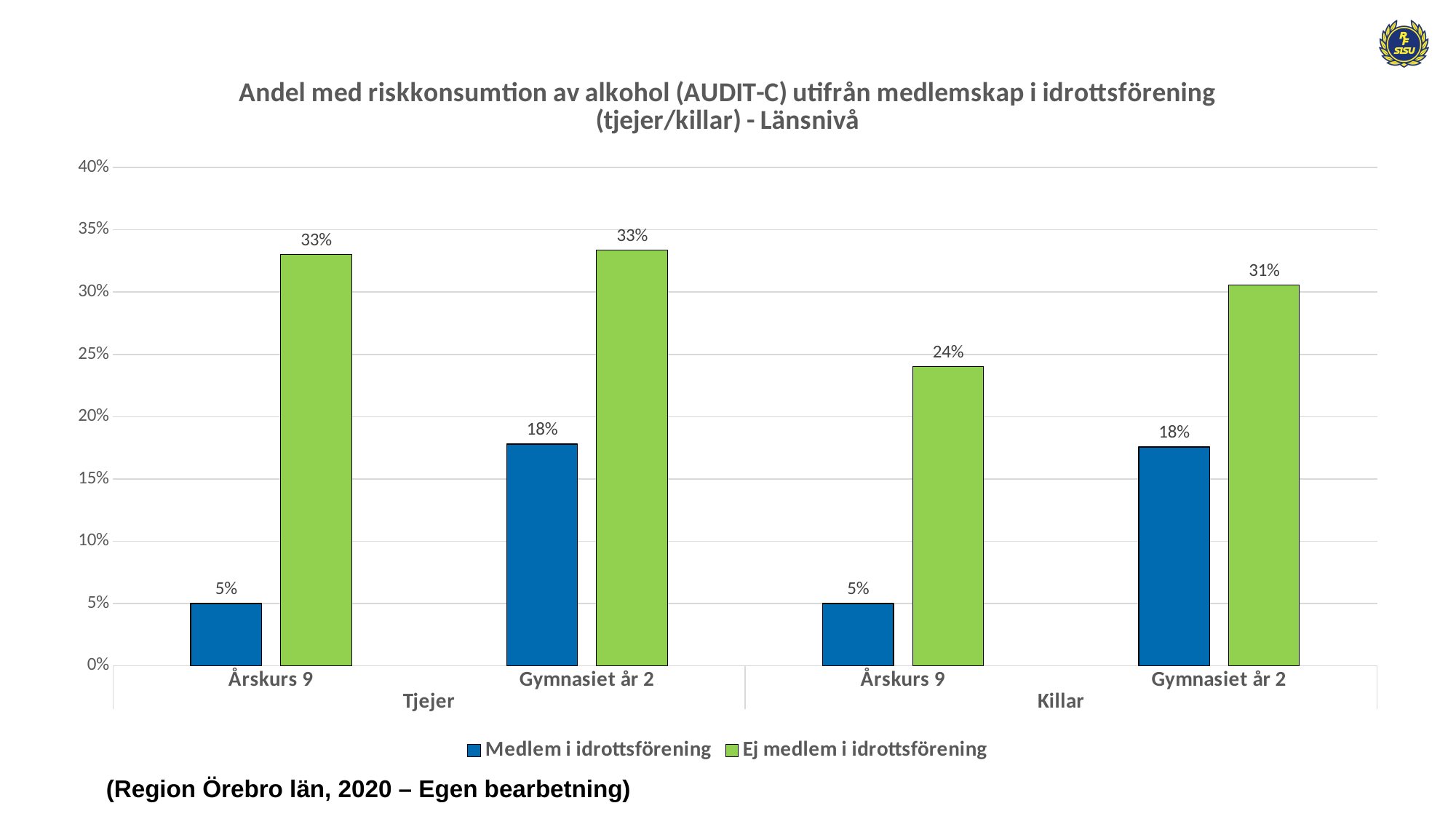
How many series does the legend list? 2 Which group has the lowest value for "Ej medlem i idrottsförening"? Killar, Årskurs 9 Which is larger: "Ej medlem i idrottsförening" for Killar in Gymnasiet år 2 or for Killar in Årskurs 9? Killar in Gymnasiet år 2 What is the value for "Ej medlem i idrottsförening" among Tjejer in Årskurs 9? 33% How many category groups are shown along the x axis? 4 What is the value for "Medlem i idrottsförening" among Tjejer in Årskurs 9? 5% What is the difference between "Ej medlem i idrottsförening" and "Medlem i idrottsförening" among Killar in Årskurs 9? 19 percentage points What is the value for "Ej medlem i idrottsförening" among Killar in Årskurs 9? 24% What is the value for "Medlem i idrottsförening" among Killar in Gymnasiet år 2? 18% Which colour represents "Medlem i idrottsförening" in the chart? Blue What kind of chart is shown on the slide? Bar chart What is the difference between "Ej medlem i idrottsförening" and "Medlem i idrottsförening" among Tjejer in Gymnasiet år 2? 15 percentage points